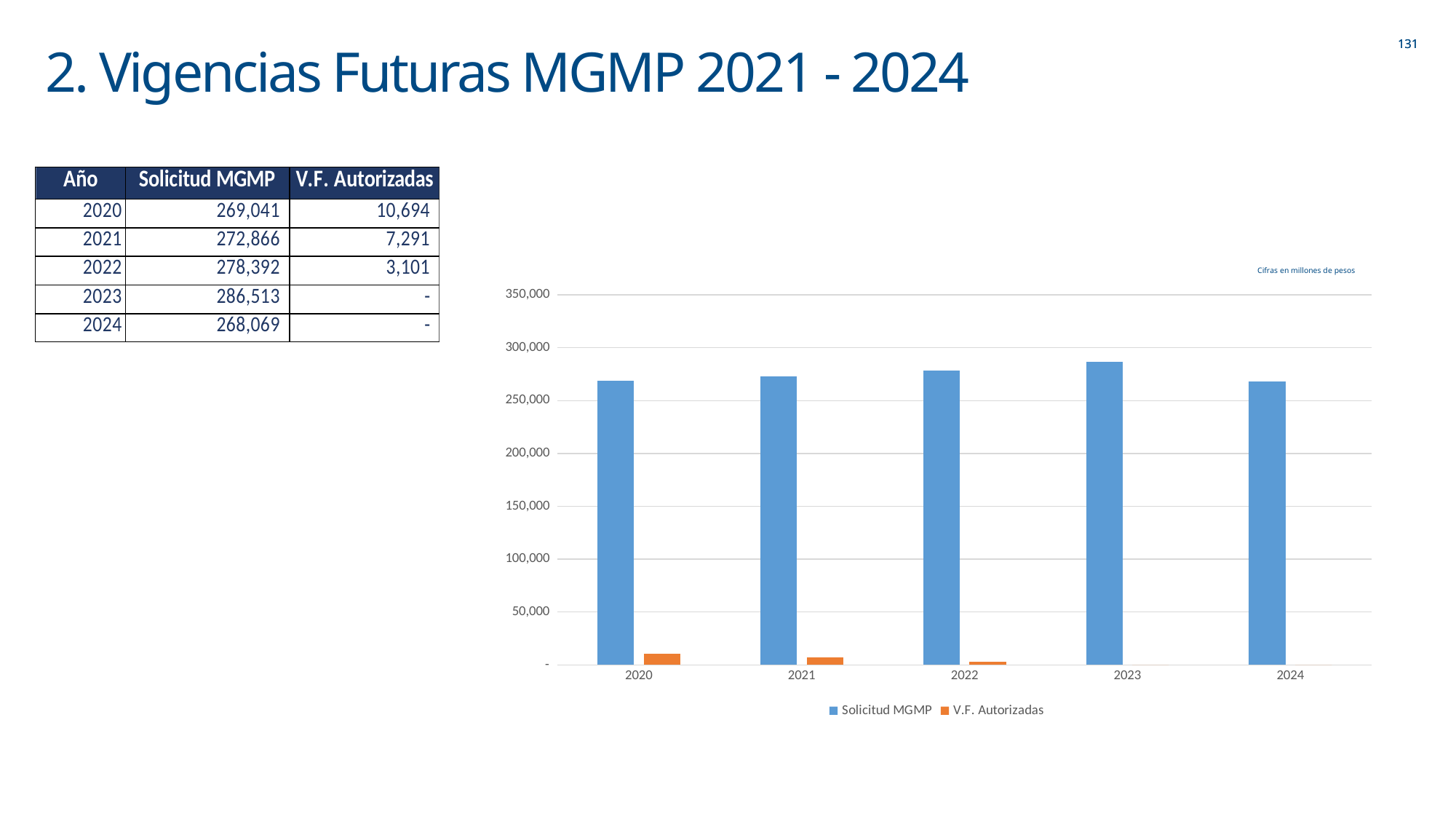
What kind of chart is shown on the slide? bar chart What is the difference between the Solicitud MGMP values for 2023 and 2024, using the values printed in the table? 18,444 What is the Solicitud MGMP value for 2023, as printed in the table on the slide? 286,513 Is the V.F. Autorizadas value for 2020 greater or less than 50,000? less Which year has the highest Solicitud MGMP bar? 2023 Which year has the highest V.F. Autorizadas bar? 2020 How many years are shown on the x axis of the chart? 5 How many series does the chart legend list? 2 Which year has the lowest Solicitud MGMP bar? 2024 Which is larger, the Solicitud MGMP bar for 2022 or for 2024? 2022 What is the V.F. Autorizadas value for 2021, as printed in the table on the slide? 7,291 Is the Solicitud MGMP value for 2023 greater or less than 250,000? greater